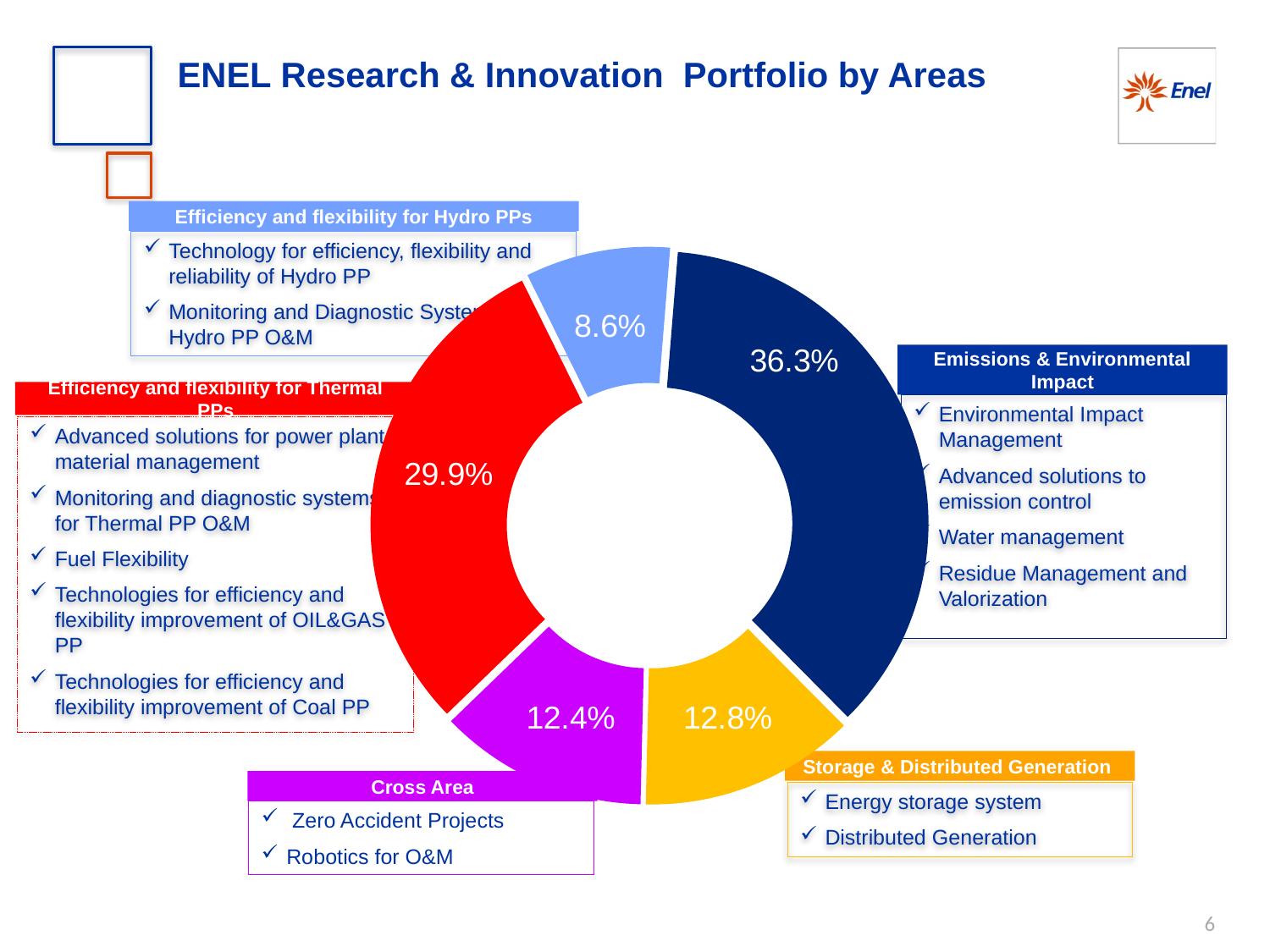
Which is larger, the Storage & Distributed Generation slice or the Efficiency and flexibility for Hydro PPs slice? Storage & Distributed Generation What percentage is shown for the Efficiency and flexibility for Thermal PPs area (red slice)? 29.9% What kind of chart is shown on the slide? Donut (pie) chart What percentage is shown for the Efficiency and flexibility for Hydro PPs area (light blue slice)? 8.6% What is the title of the slide containing the chart? ENEL Research & Innovation Portfolio by Areas How many slices does the donut chart have? 5 What percentage is shown for the Storage & Distributed Generation area (yellow slice)? 12.8% What share of the portfolio does the Emissions & Environmental Impact area (dark blue slice) hold? 36.3% Which area has the smallest share of the portfolio? Efficiency and flexibility for Hydro PPs Which area has the largest share of the portfolio? Emissions & Environmental Impact What is the difference in percentage points between the Emissions & Environmental Impact slice and the Efficiency and flexibility for Thermal PPs slice? 6.4 What percentage is shown for the Cross Area (magenta slice)? 12.4%